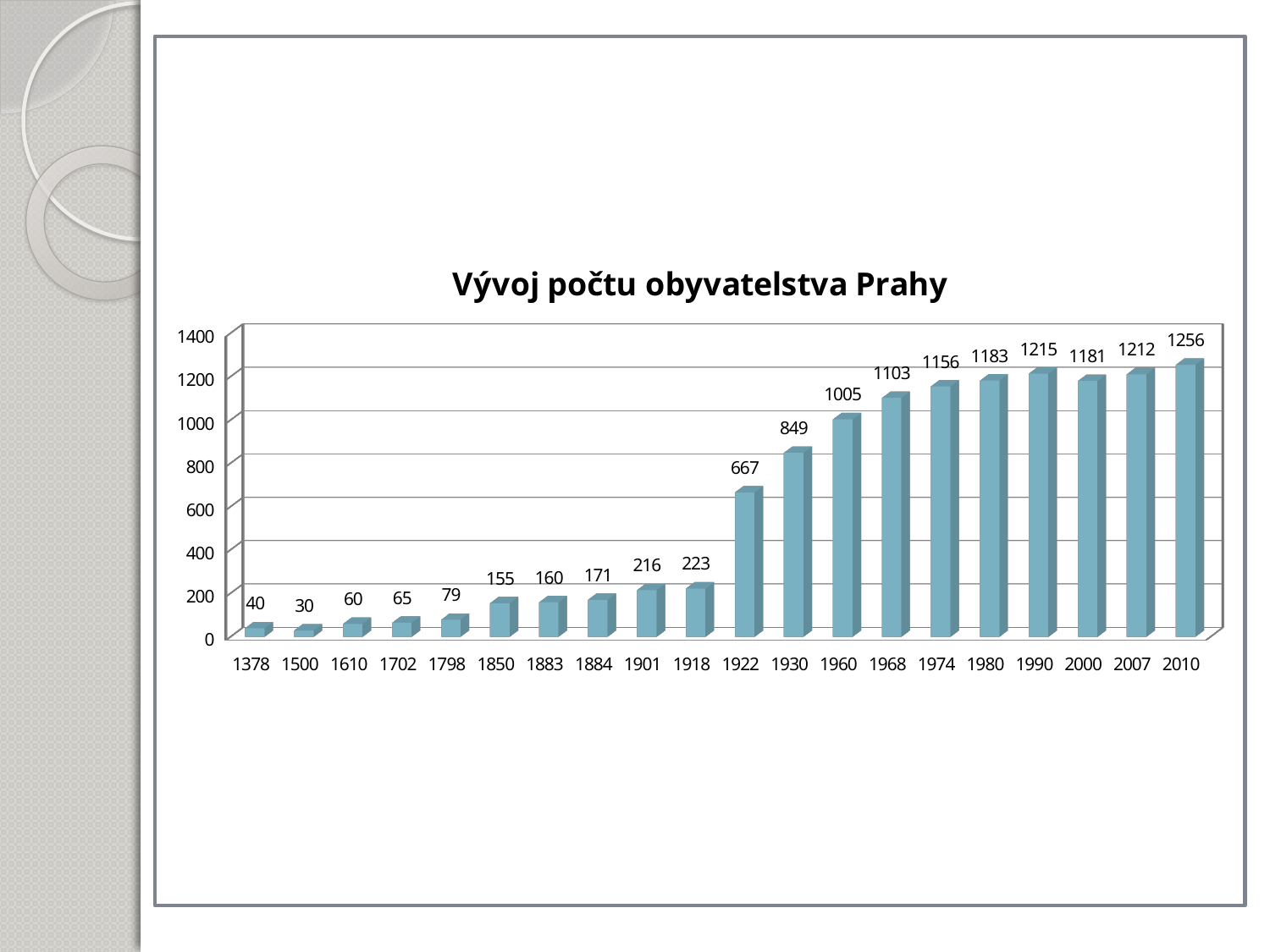
Which year has the lowest value? 1500 Is the value for 1960 greater or less than 800? greater Which year has the highest value? 2010 What is the difference between the values for 2010 and 2007? 44 What kind of chart is this? bar chart What is the value for 1850? 155 What is the value for 1922? 667 Which is larger, the value for 1990 or the value for 2000? 1990 How many years are shown on the x axis? 20 What is the difference between the values for 1930 and 1922? 182 What is the title of the chart? Vývoj počtu obyvatelstva Prahy What is the value for 2000? 1181